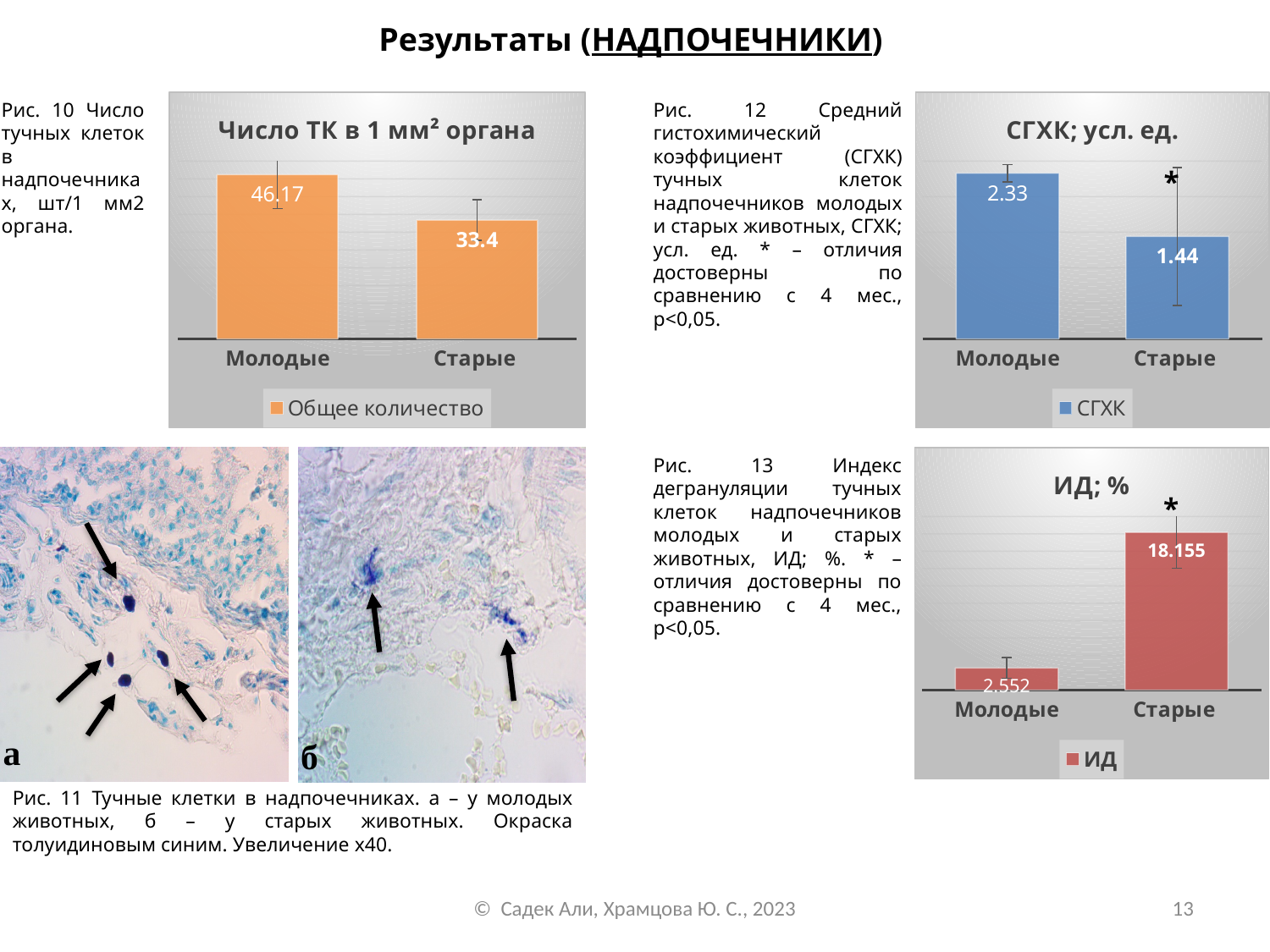
In the chart titled "ИД; %", what is the value for Молодые? 2.552 In the chart titled "Число ТК в 1 мм² органа", what is the difference between the values for Молодые and Старые? 12.77 In the chart titled "СГХК; усл. ед.", what is the value for Молодые? 2.33 What kind of chart is the chart titled "СГХК; усл. ед."? Bar chart In the chart titled "ИД; %", what is the difference between the values for Старые and Молодые? 15.603 In the chart titled "ИД; %", which category has the lowest value? Молодые In the chart titled "СГХК; усл. ед.", what is the difference between the values for Молодые and Старые? 0.89 In the chart titled "ИД; %", what is the value for Старые? 18.155 In the chart titled "Число ТК в 1 мм² органа", which category has the higher value? Молодые In the chart titled "СГХК; усл. ед.", what is the value for Старые? 1.44 In the chart titled "Число ТК в 1 мм² органа", what is the value for Старые? 33.4 In the chart titled "Число ТК в 1 мм² органа", what is the value for Молодые? 46.17